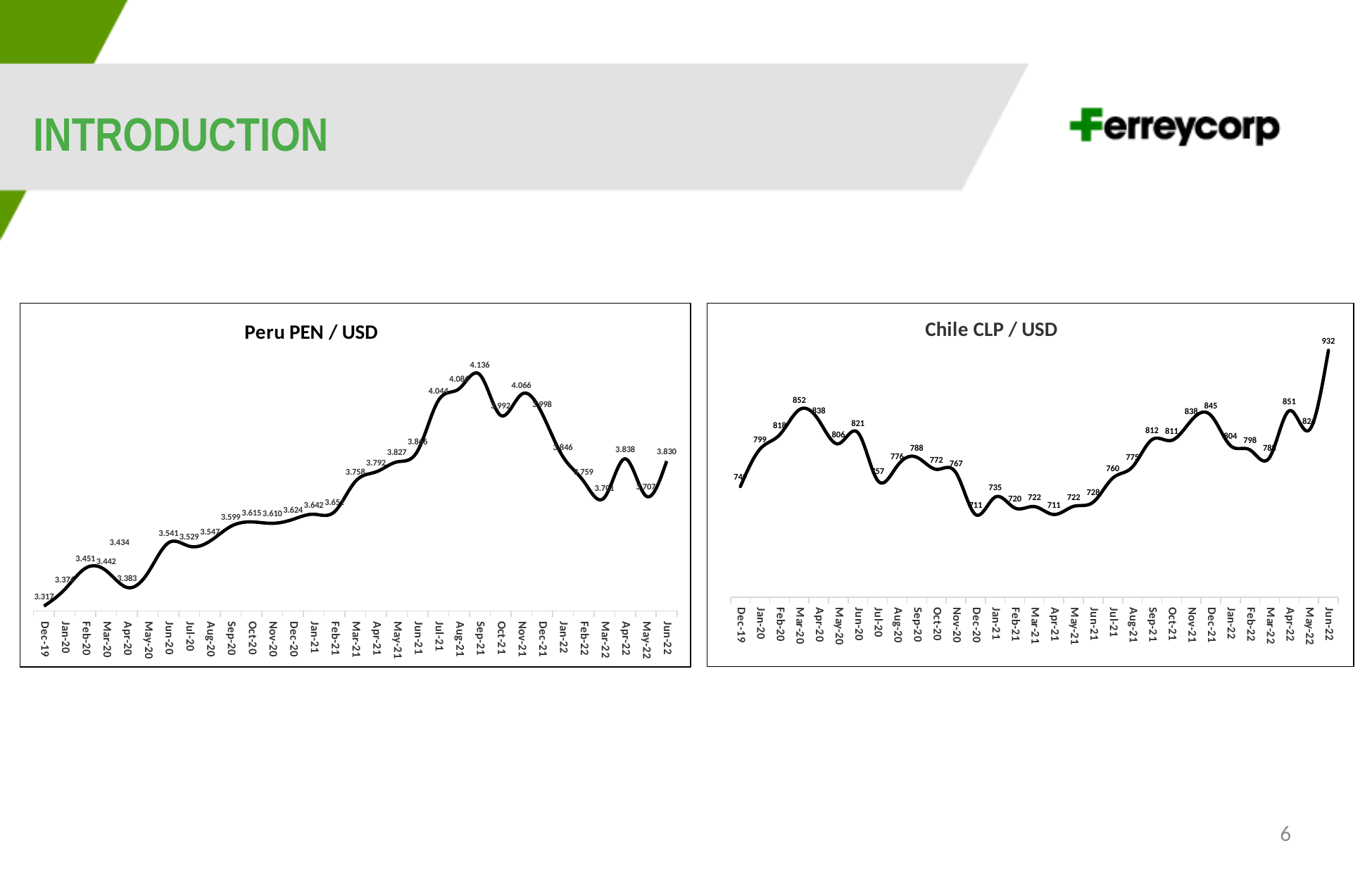
What type of chart is the Peru PEN / USD chart? Line chart In the Peru PEN / USD chart, what is the value for Jun-22? 3.830 In the Peru PEN / USD chart, what is the difference between the Sep-21 value and the Dec-19 value? 0.819 In the Chile CLP / USD chart, what is the value for Jun-22? 932 In the Chile CLP / USD chart, what is the value for Mar-20? 852 In the Peru PEN / USD chart, which month has the highest value? Sep-21 In the Chile CLP / USD chart, which month has the highest value? Jun-22 In the Peru PEN / USD chart, which is larger, the value for Apr-22 or the value for May-22? Apr-22 In the Chile CLP / USD chart, what is the difference between the Jun-22 value and the Dec-21 value? 87 In the Peru PEN / USD chart, what is the value for Sep-21? 4.136 How many monthly data points does the Chile CLP / USD chart plot? 31 In the Peru PEN / USD chart, which month has the lowest value? Dec-19